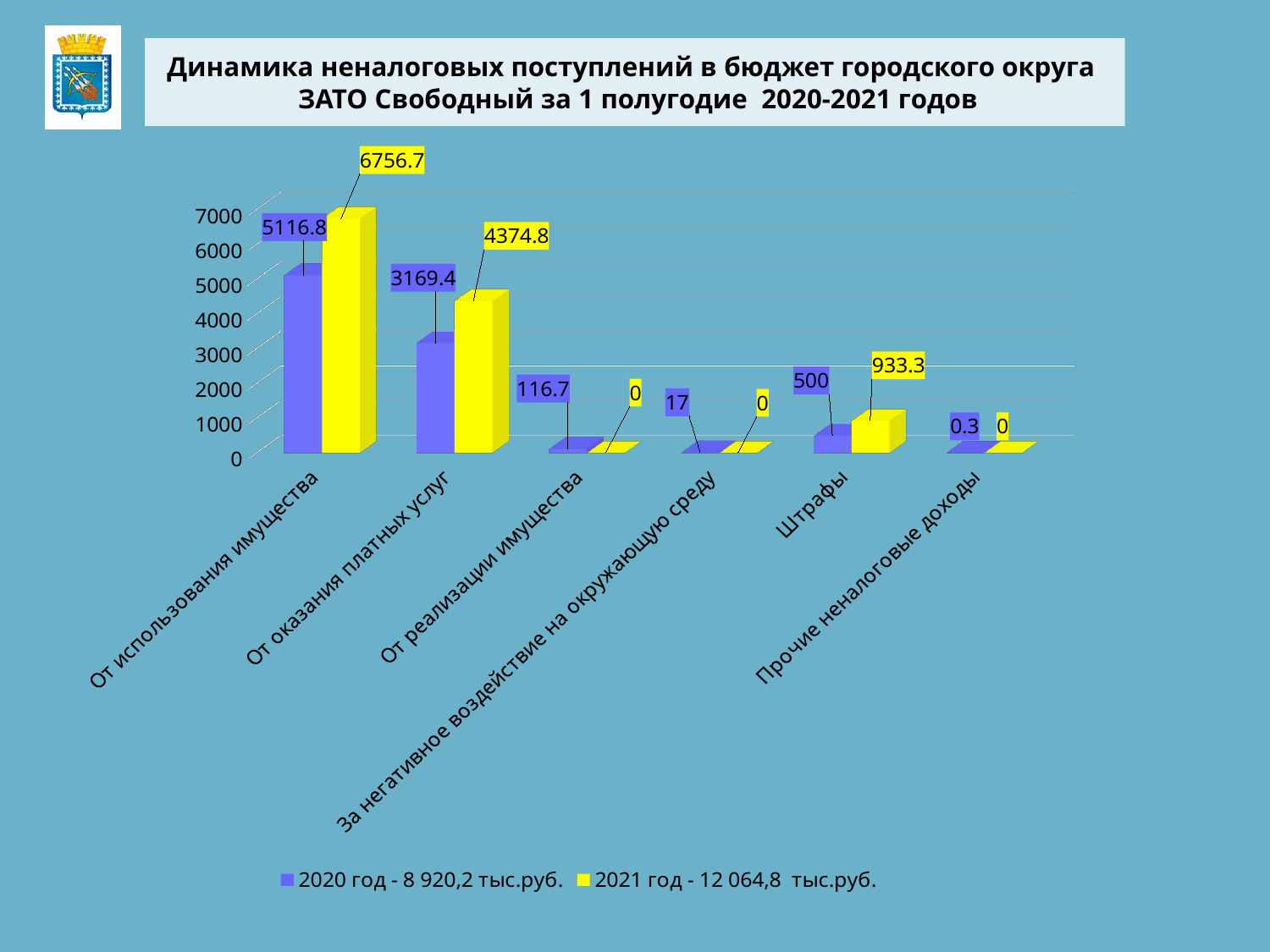
Which category has the highest 2021 value? От использования имущества According to the legend, what is the total for 2021? 12 064,8 тыс.руб. What is the 2021 value for «Штрафы»? 933.3 What is the 2021 value for «От оказания платных услуг»? 4374.8 Which is larger for «Штрафы»: the 2020 value or the 2021 value? 2021 What is the 2020 value for «За негативное воздействие на окружающую среду»? 17 How many categories are shown on the x axis? 6 How many series does the legend list? 2 What is the difference between the 2021 and 2020 values for «От использования имущества»? 1639.9 Which category has the lowest 2020 value? Прочие неналоговые доходы What kind of chart is shown on the slide? Bar chart What is the 2020 value for «От использования имущества»? 5116.8